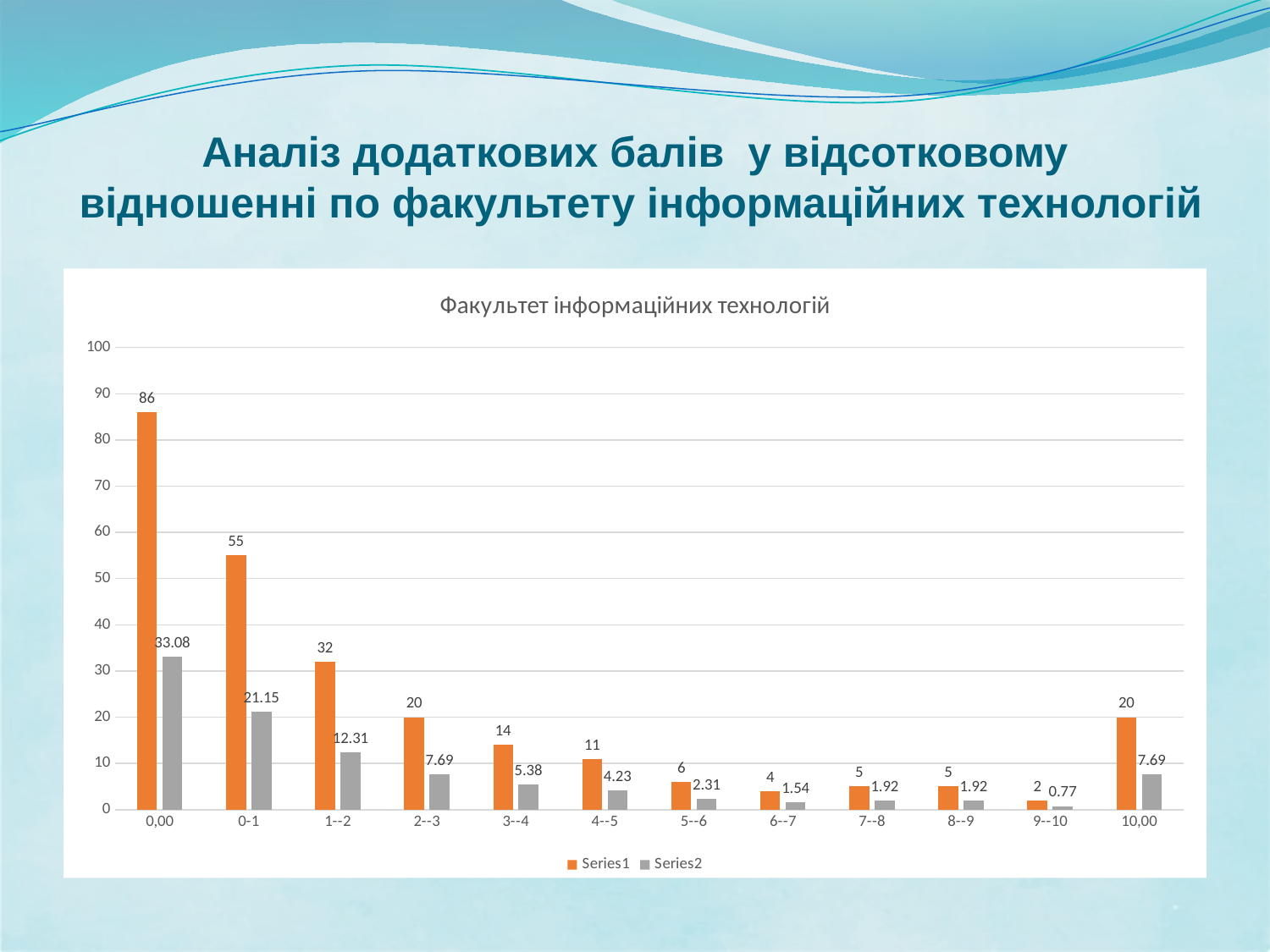
Is the Series1 value for 0-1 greater or less than 50? greater Which category has the highest Series1 value? 0,00 Which category has the lowest Series2 value? 9--10 What is the Series2 value for the category 10,00? 7.69 What is the Series1 value for the category 0,00? 86 Which is larger: the Series1 value for 2--3 or the Series1 value for 3--4? 2--3 What is the Series2 value for the category 1--2? 12.31 How many series does the legend list? 2 How many categories are shown on the x axis? 12 What is the title of the chart? Факультет інформаційних технологій What is the difference between the Series1 values for 0,00 and 0-1? 31 What kind of chart is shown on the slide? bar chart